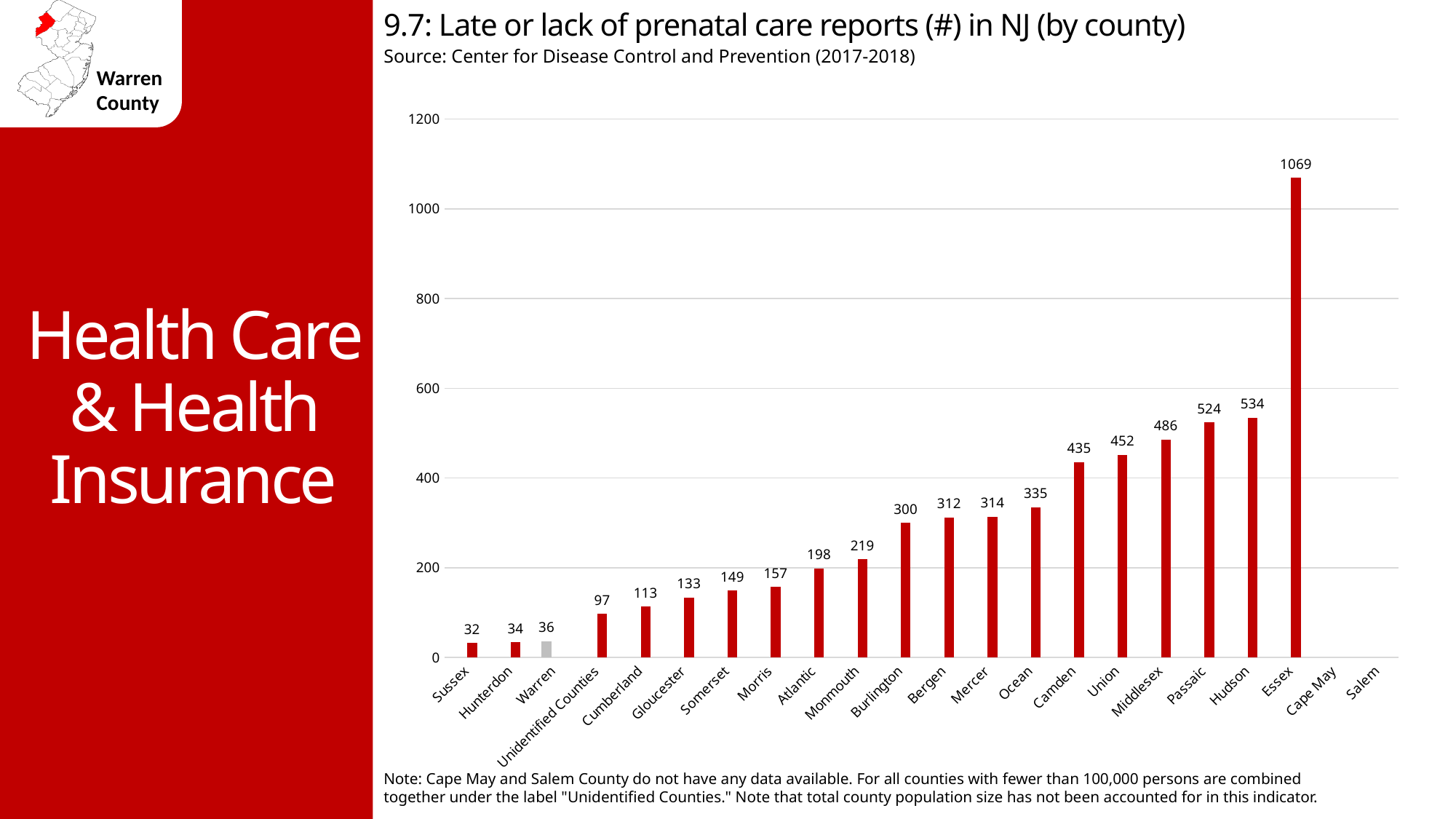
What is the value shown for Unidentified Counties? 97 What is the difference between the values for Essex and Hudson? 535 Is the value for Middlesex greater or less than 400? greater What is the number of late or lack of prenatal care reports for Warren? 36 What is the value shown for Essex? 1069 Which county has the highest number of late or lack of prenatal care reports? Essex How many counties are labeled on the x axis, including Unidentified Counties? 22 What is the difference between the values for Hudson and Passaic? 10 What kind of chart is shown on the slide? Bar chart Which county with a plotted value has the lowest number of reports? Sussex Which bar is shown in grey rather than red? Warren Which has a higher value, Camden or Union? Union